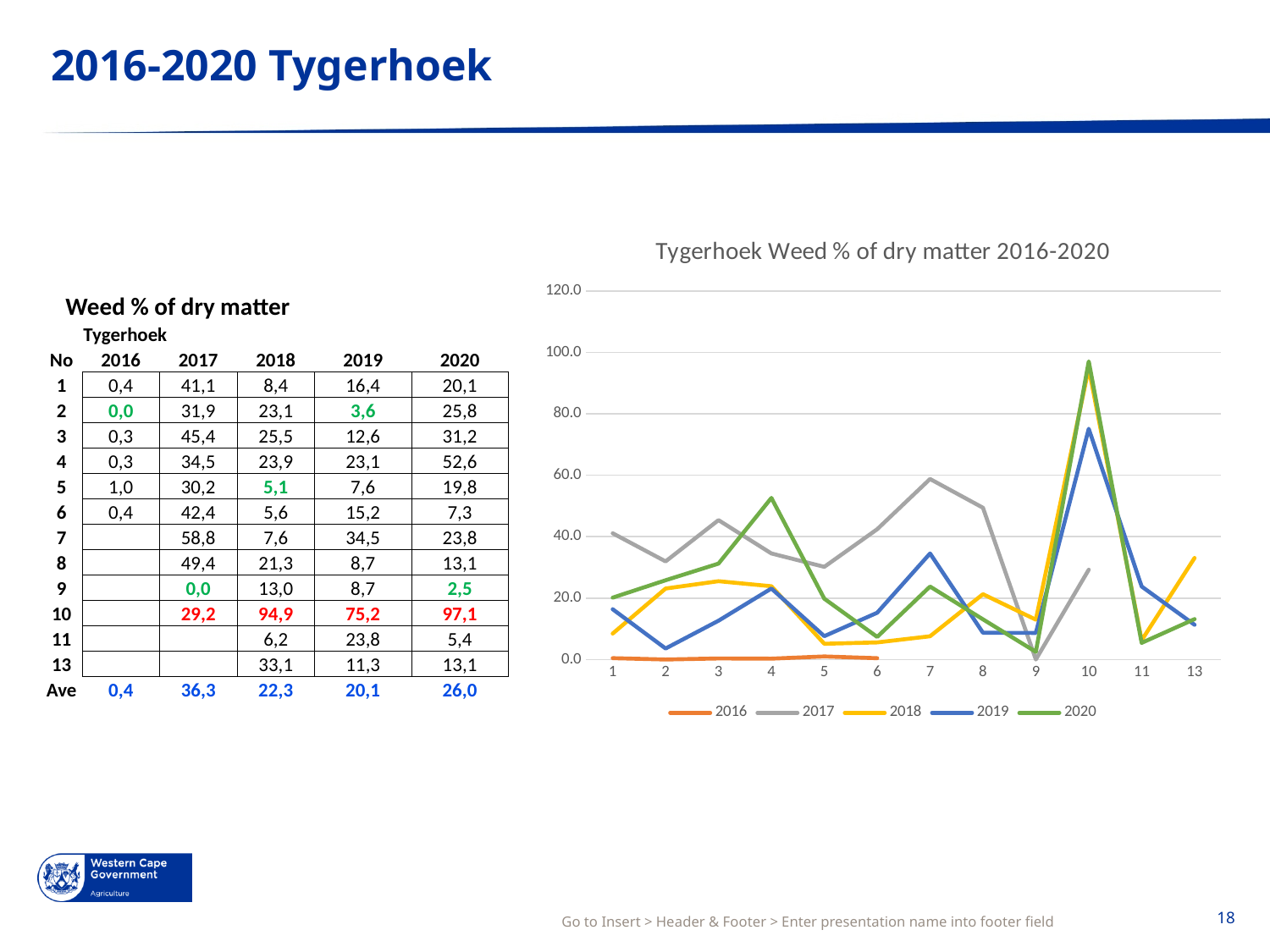
At which x-axis number does the 2020 series reach its highest value? 10 Is the value for 2016 at number 1 greater or less than 20? less At number 4, which series has the larger value, 2020 or 2017? 2020 How many points are plotted along the x axis of the chart? 12 Is the value for 2019 at number 10 greater or less than 60? greater What is the title of the chart? Tygerhoek Weed % of dry matter 2016-2020 At which x-axis number does the 2017 series reach its lowest value? 9 Does the 2019 series rise or fall from number 10 to number 13? fall What kind of chart is shown on the slide? line chart How many series does the chart legend list? 5 According to the table, what is the 2020 value at number 10? 97,1 Is the value for 2017 at number 7 greater or less than 40? greater